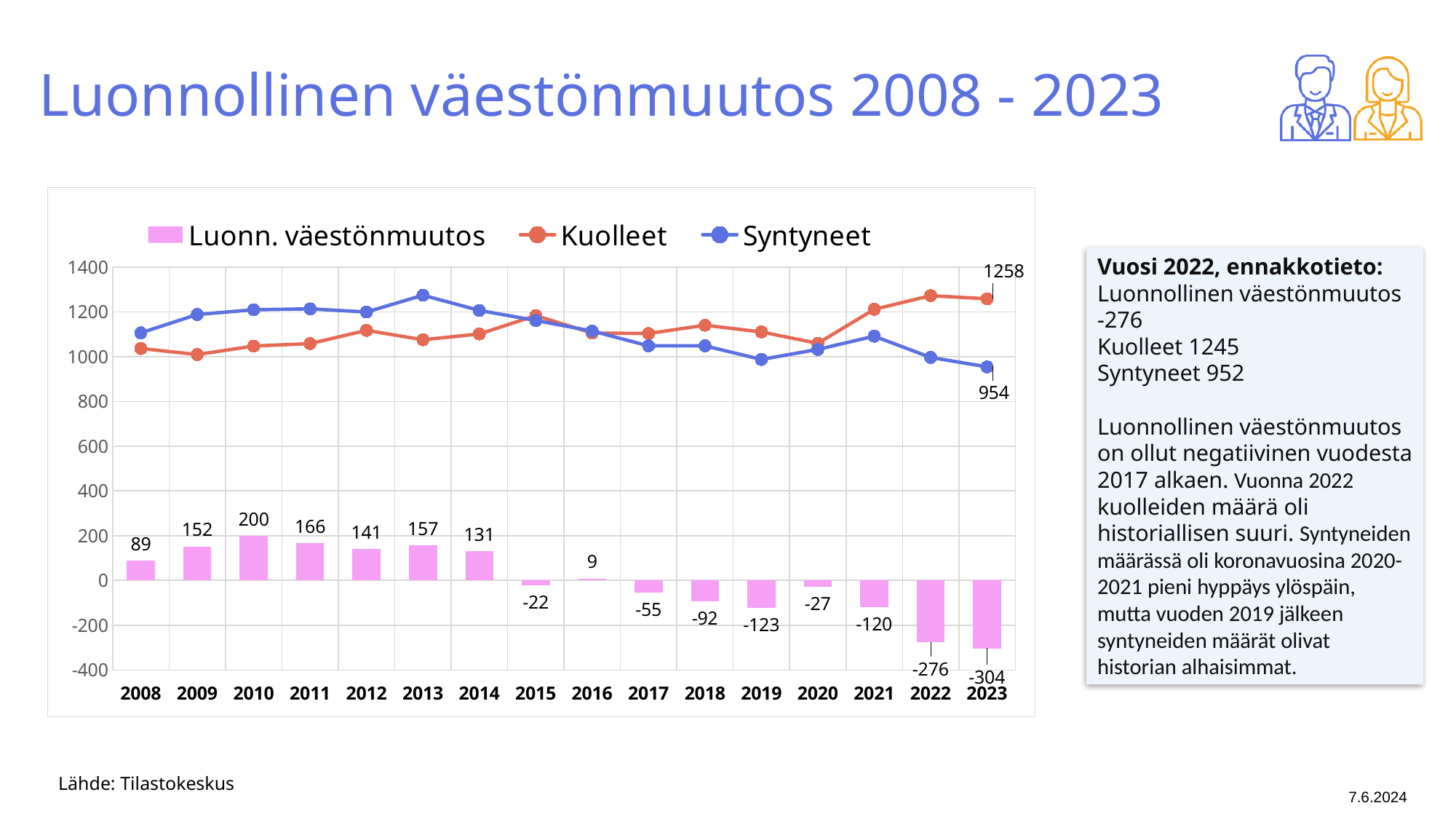
Does the Syntyneet line rise or fall from 2021 to 2023? fall Which is larger in 2023, Kuolleet or Syntyneet? Kuolleet What is the difference between the Luonn. väestönmuutos values for 2022 and 2023? 28 How many years are shown on the x axis? 16 Which year has the highest Luonn. väestönmuutos value? 2010 Which year has the lowest Luonn. väestönmuutos value? 2023 What is the Kuolleet value for 2023? 1258 What is the value of Luonn. väestönmuutos for 2023? -304 What is the Syntyneet value for 2023? 954 What is the value of Luonn. väestönmuutos for 2010? 200 How many series does the legend list? 3 Is the Syntyneet value for 2013 greater or less than 1200? greater